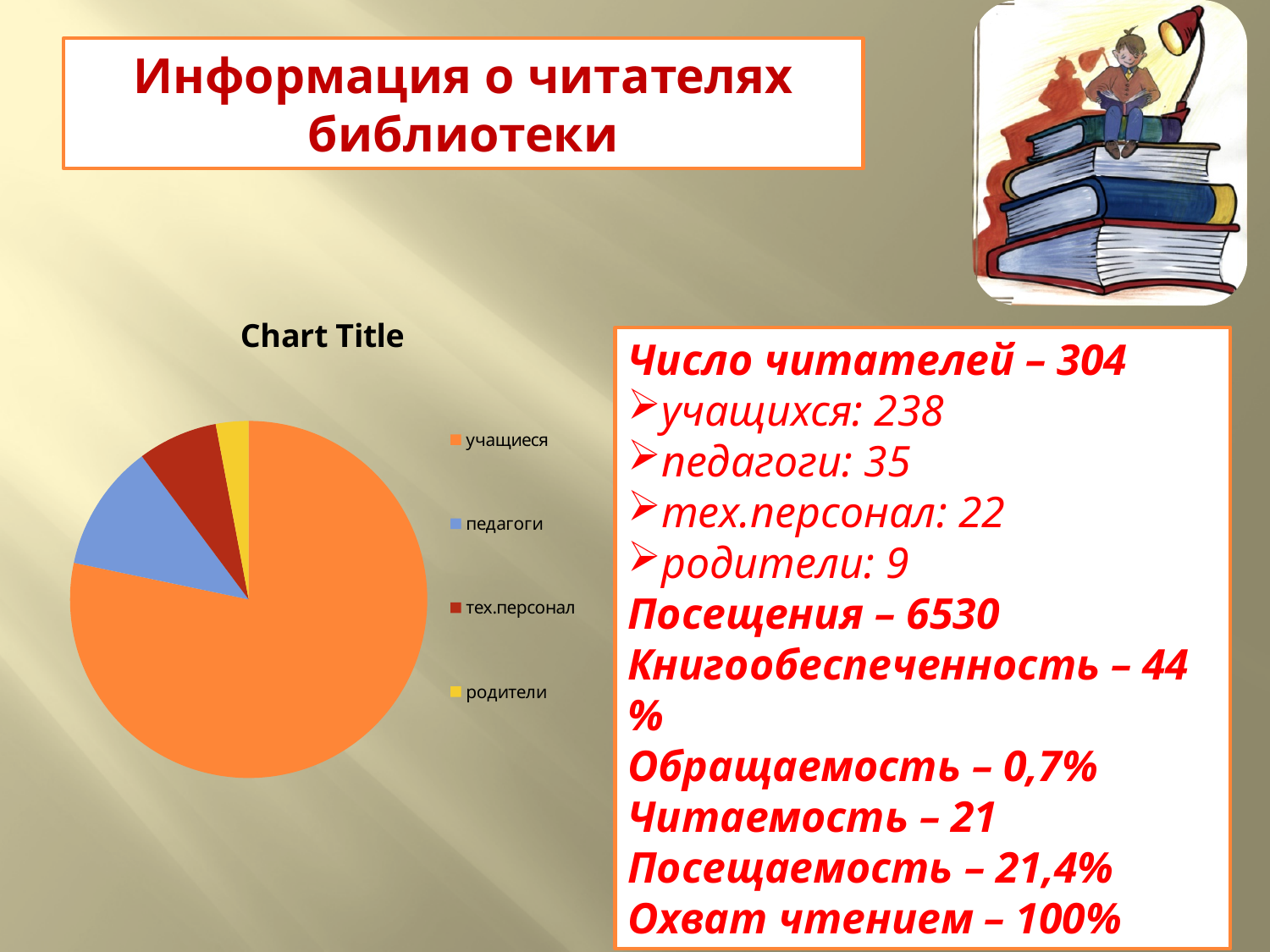
What is the title shown above the pie chart? Chart Title What kind of chart is shown on the slide? pie chart According to the slide, what is the total number of readers (Число читателей)? 304 How many slices does the pie chart have? 4 Which slice is larger in the pie chart, педагоги or тех.персонал? педагоги Which category has the largest slice of the pie chart? учащиеся According to the slide, how many родители are among the library readers? 9 Which category has the smallest slice of the pie chart? родители Which slice is larger in the pie chart, тех.персонал or родители? тех.персонал How many entries does the pie chart's legend list? 4 According to the slide, how many учащихся are among the library readers? 238 What colour is the учащиеся slice in the pie chart? orange